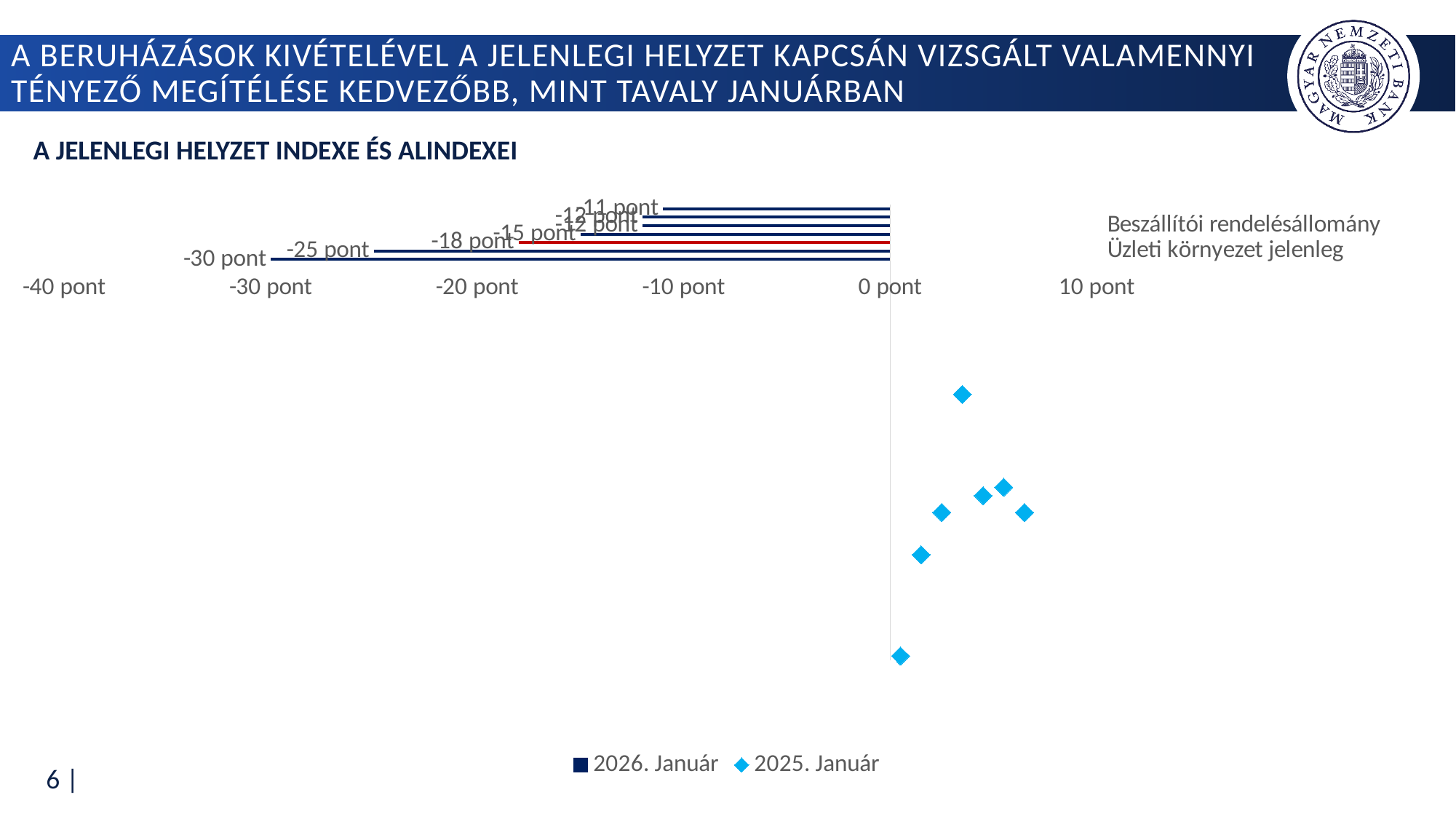
What is the title of the chart? A JELENLEGI HELYZET INDEXE ÉS ALINDEXEI Are all the labeled 2026. Január bar values greater or less than 0 pont? less Is the lowest labeled 2026. Január bar value greater or less than -20 pont? less What kind of chart is shown on the slide? bar chart What is the lowest value labeled on the 2026. Január bars? -30 pont What are the two series named in the legend? 2026. Január and 2025. Január How many series does the legend list? 2